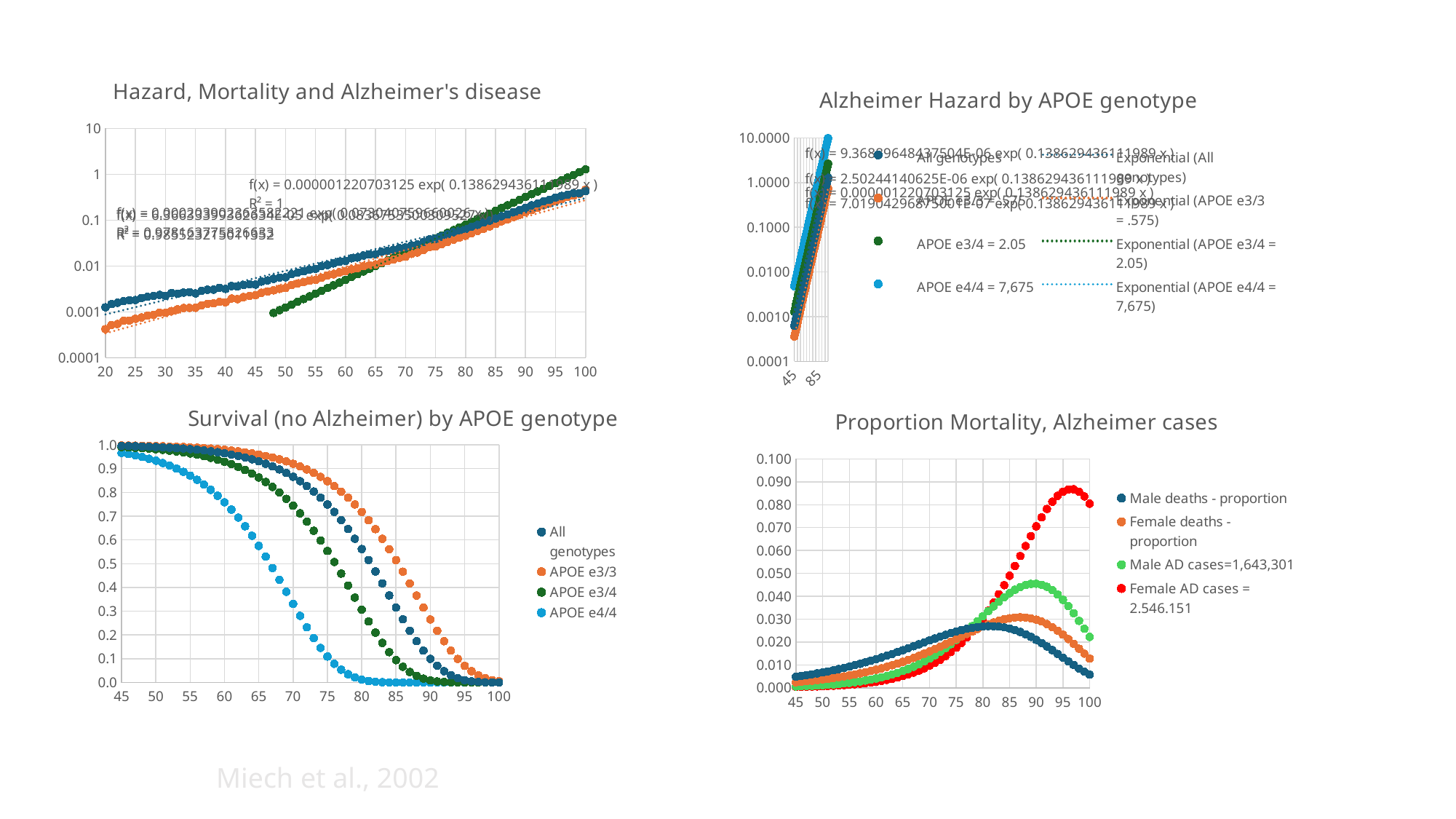
In the 'Survival (no Alzheimer) by APOE genotype' chart, is the value for APOE e3/3 at age 80 greater or less than 0.5? greater In the 'Survival (no Alzheimer) by APOE genotype' chart, is the value for APOE e4/4 at age 70 greater or less than 0.5? less In the 'Survival (no Alzheimer) by APOE genotype' chart, at age 75, which is larger: APOE e3/3 or APOE e4/4? APOE e3/3 In the 'Proportion Mortality, Alzheimer cases' chart, which series reaches the highest peak value? Female AD cases = 2.546.151 In the 'Survival (no Alzheimer) by APOE genotype' chart, how many series does the legend list? 4 How many charts are shown on the slide? 4 In the 'Proportion Mortality, Alzheimer cases' chart, what number of cases is given in the legend entry for Male AD cases? 1,643,301 In the 'Survival (no Alzheimer) by APOE genotype' chart, which series drops to the lowest survival at age 70? APOE e4/4 In the 'Alzheimer Hazard by APOE genotype' chart, what value is shown in the legend entry for APOE e3/4? 2.05 In the 'Proportion Mortality, Alzheimer cases' chart, is the peak value of the Female AD cases series greater or less than 0.080? greater In the 'Proportion Mortality, Alzheimer cases' chart, how many series does the legend list? 4 In the 'Survival (no Alzheimer) by APOE genotype' chart, do the values rise or fall as age increases along the x axis? fall